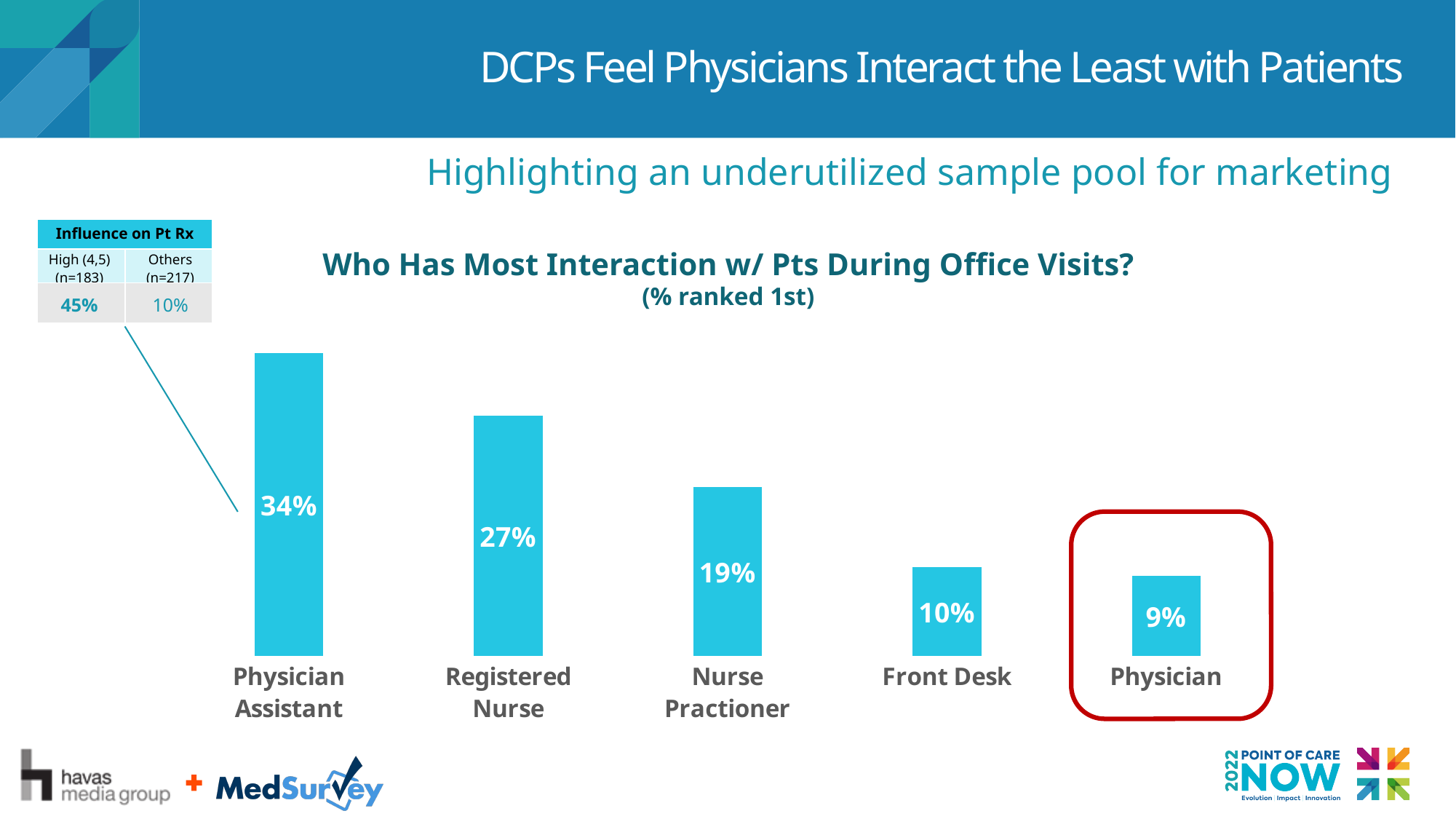
What is the title of the chart? Who Has Most Interaction w/ Pts During Office Visits? What is the value shown for Registered Nurse? 27% Which category has the lowest value in the chart? Physician What is the value shown for Physician? 9% What is the value shown for Nurse Practioner? 19% How many categories are shown in the chart? 5 Which is larger, the value for Registered Nurse or the value for Nurse Practioner? Registered Nurse What is the difference between the values for Physician Assistant and Physician? 25% What is the value shown for Front Desk? 10% Which category has the highest value in the chart? Physician Assistant What kind of chart is shown on the slide? Bar chart What percentage ranked Physician Assistant 1st for most interaction with patients during office visits? 34%